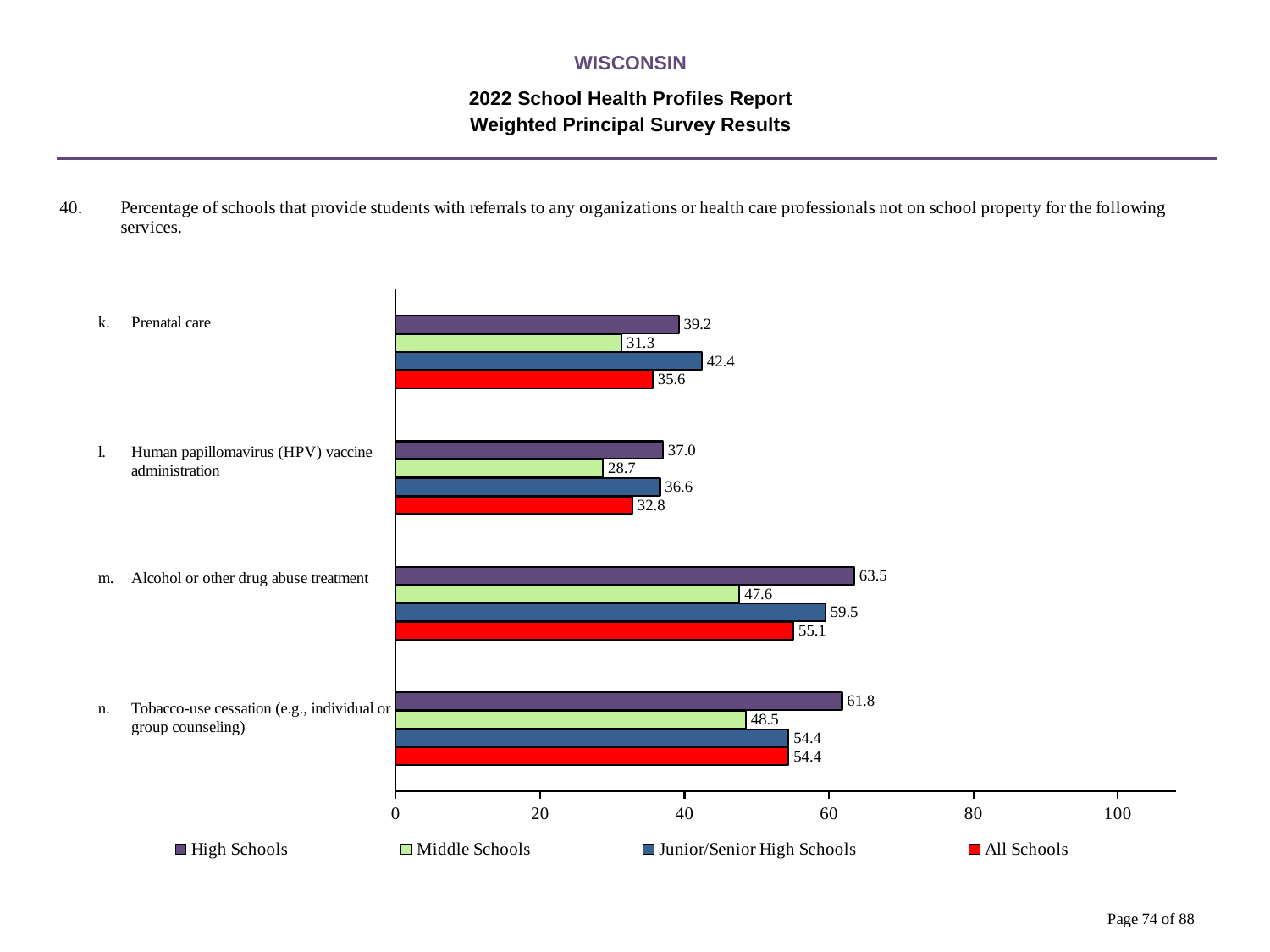
How many categories are shown on the chart? 4 Which is larger for Prenatal care: the High Schools value or the Junior/Senior High Schools value? Junior/Senior High Schools What is the value for Junior/Senior High Schools for Tobacco-use cessation (e.g., individual or group counseling)? 54.4 What is the value for High Schools for Prenatal care? 39.2 What is the value for Middle Schools for Human papillomavirus (HPV) vaccine administration? 28.7 Is the value for Middle Schools for Tobacco-use cessation greater or less than 40? greater What is the value for All Schools for Alcohol or other drug abuse treatment? 55.1 What kind of chart is shown on the slide? Bar chart What is the difference between the High Schools and Middle Schools values for Alcohol or other drug abuse treatment? 15.9 How many series does the legend list? 4 Which category has the lowest value for Middle Schools? Human papillomavirus (HPV) vaccine administration Which category has the highest value for High Schools? Alcohol or other drug abuse treatment